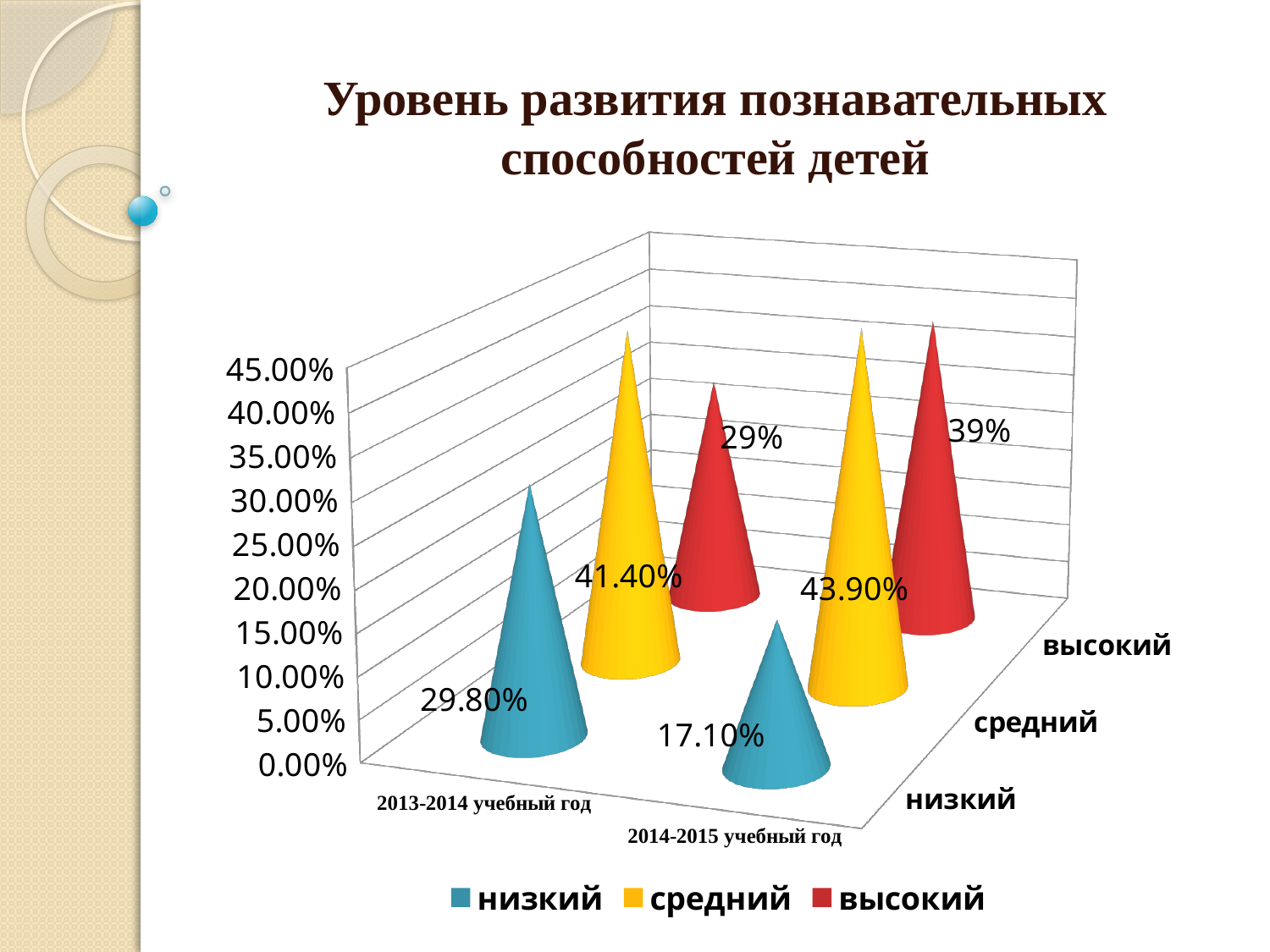
What is the value for средний in 2014-2015 учебный год? 43.90% What is the value for низкий in 2013-2014 учебный год? 29.80% Which series has the lowest value in 2014-2015 учебный год? низкий What is the difference between the высокий values for 2014-2015 учебный год and 2013-2014 учебный год? 10% What is the value for низкий in 2014-2015 учебный год? 17.10% What kind of chart is shown on the slide? 3D bar chart (cone-shaped bars) How many series does the legend list? 3 Which series has the highest value in 2014-2015 учебный год? средний Which is larger: the низкий value for 2013-2014 учебный год or for 2014-2015 учебный год? 2013-2014 учебный год What is the value for высокий in 2013-2014 учебный год? 29% What is the title of the chart? Уровень развития познавательных способностей детей How many academic years (categories) are shown on the chart? 2